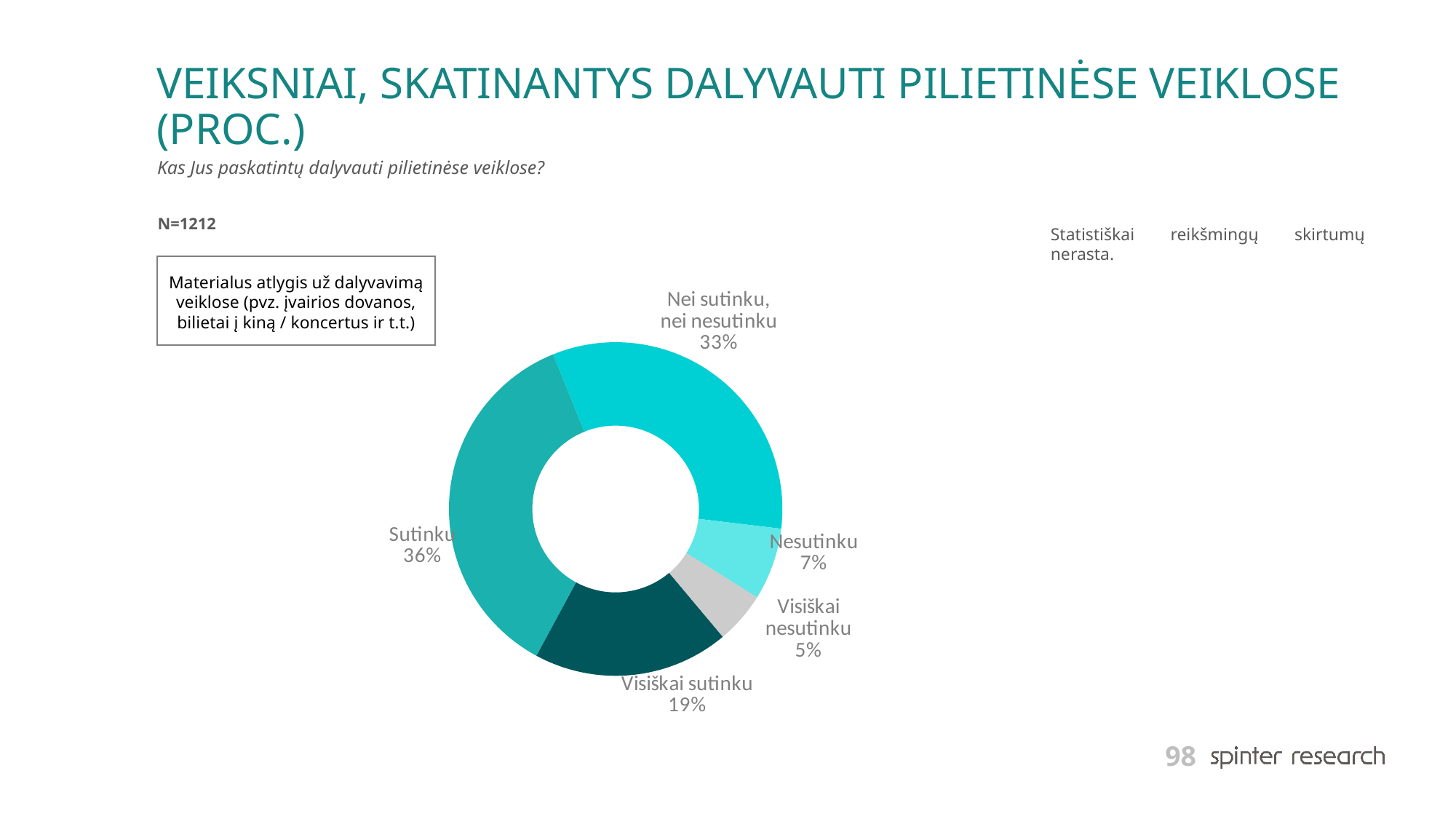
Which response category has the smallest share? Visiškai nesutinku What percentage of respondents answered "Sutinku"? 36% How many response categories are shown in the chart? 5 What percentage of respondents answered "Visiškai nesutinku"? 5% What percentage of respondents answered "Nei sutinku, nei nesutinku"? 33% What is the sample size (N) stated on the slide? N=1212 What is the difference in percentage points between "Sutinku" and "Visiškai sutinku"? 17 What percentage of respondents answered "Visiškai sutinku"? 19% Which response category has the largest share? Sutinku What type of chart is shown on the slide? Pie chart (doughnut) Which is larger, the share for "Nesutinku" or the share for "Visiškai nesutinku"? Nesutinku What percentage of respondents answered "Nesutinku"? 7%